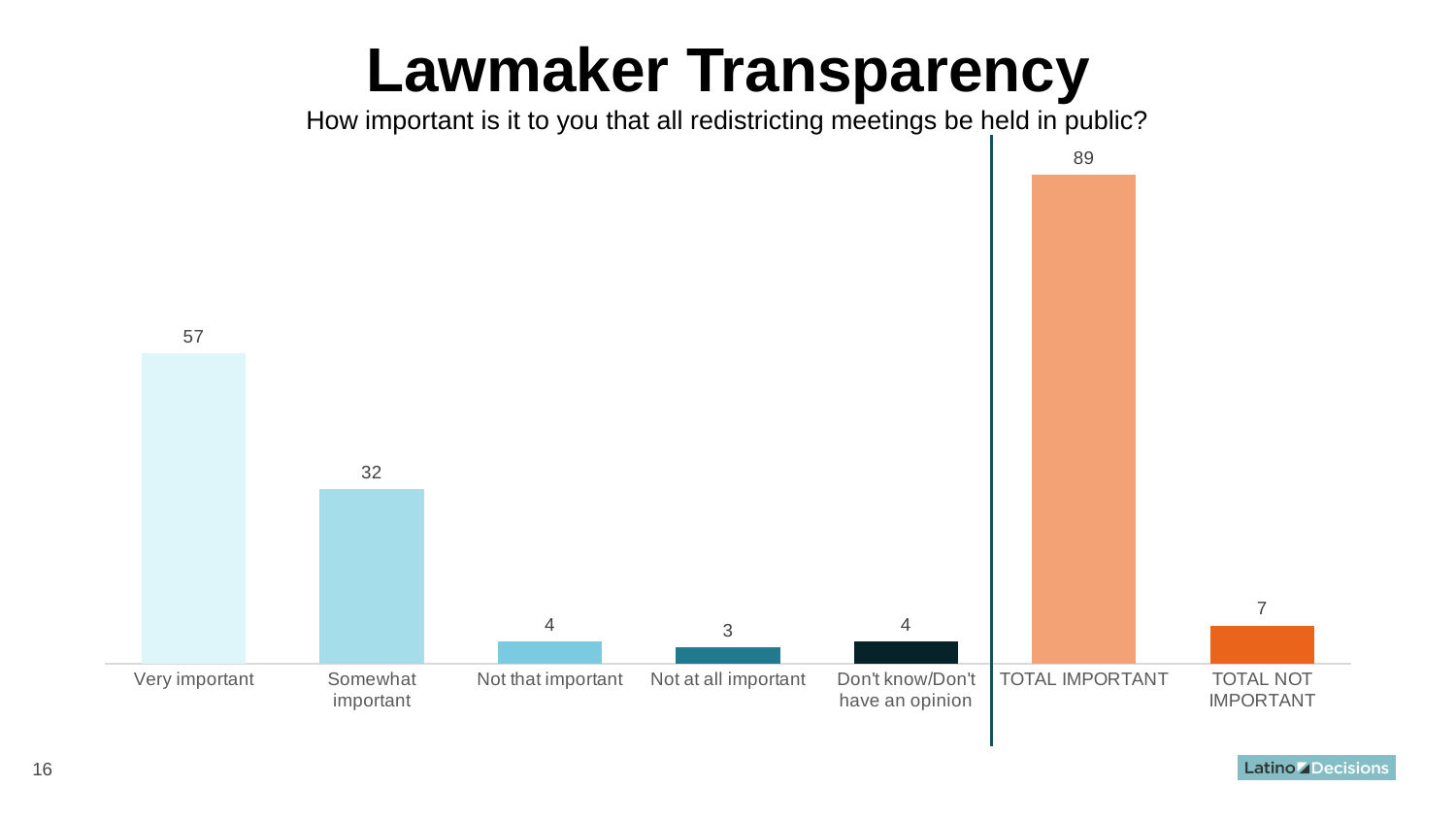
What is the value for Very important? 57 What is the difference between Very important and Somewhat important? 25 How many categories are shown on the x axis? 7 Which is larger, TOTAL NOT IMPORTANT or Don't know/Don't have an opinion? TOTAL NOT IMPORTANT What is the value for TOTAL NOT IMPORTANT? 7 What is the value for Not at all important? 3 What is the title of the slide? Lawmaker Transparency Which category has the highest value? TOTAL IMPORTANT What is the value for Somewhat important? 32 What kind of chart is this? Bar chart What is the value for TOTAL IMPORTANT? 89 Which category has the lowest value? Not at all important